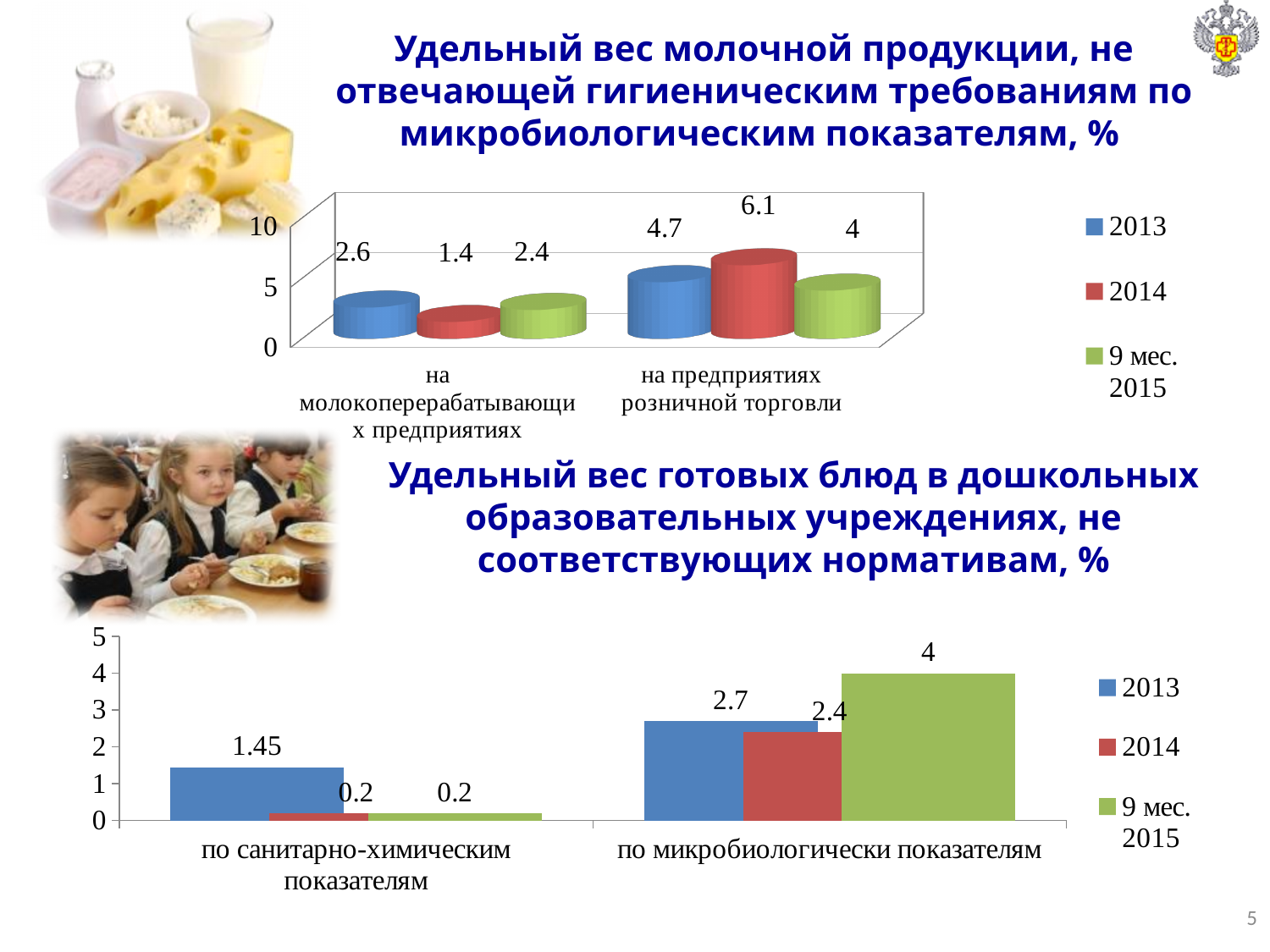
In the top chart (Удельный вес молочной продукции), what is the difference between the 2014 and 2013 values at предприятия розничной торговли? 1.4 What kind of chart is the bottom chart (Удельный вес готовых блюд)? bar chart In the bottom chart (Удельный вес готовых блюд), which is larger по микробиологически показателям: the 2013 value or the 2014 value? 2013 In the top chart (Удельный вес молочной продукции), what is the value for 2013 at молокоперерабатывающие предприятия? 2.6 In the bottom chart (Удельный вес готовых блюд), what is the difference between the 2013 value and the 2014 value по санитарно-химическим показателям? 1.25 In the top chart (Удельный вес молочной продукции), is the 2014 value at предприятия розничной торговли greater or less than 5? greater In the bottom chart (Удельный вес готовых блюд), what is the value for 9 мес. 2015 по микробиологически показателям? 4 In the bottom chart (Удельный вес готовых блюд), which series has the highest value по микробиологически показателям? 9 мес. 2015 In the top chart (Удельный вес молочной продукции), what is the value for 2014 at предприятия розничной торговли? 6.1 In the top chart (Удельный вес молочной продукции), which series has the lowest value at молокоперерабатывающие предприятия? 2014 In the bottom chart (Удельный вес готовых блюд), what is the value for 2013 по санитарно-химическим показателям? 1.45 In the top chart (Удельный вес молочной продукции), how many series does the legend list? 3